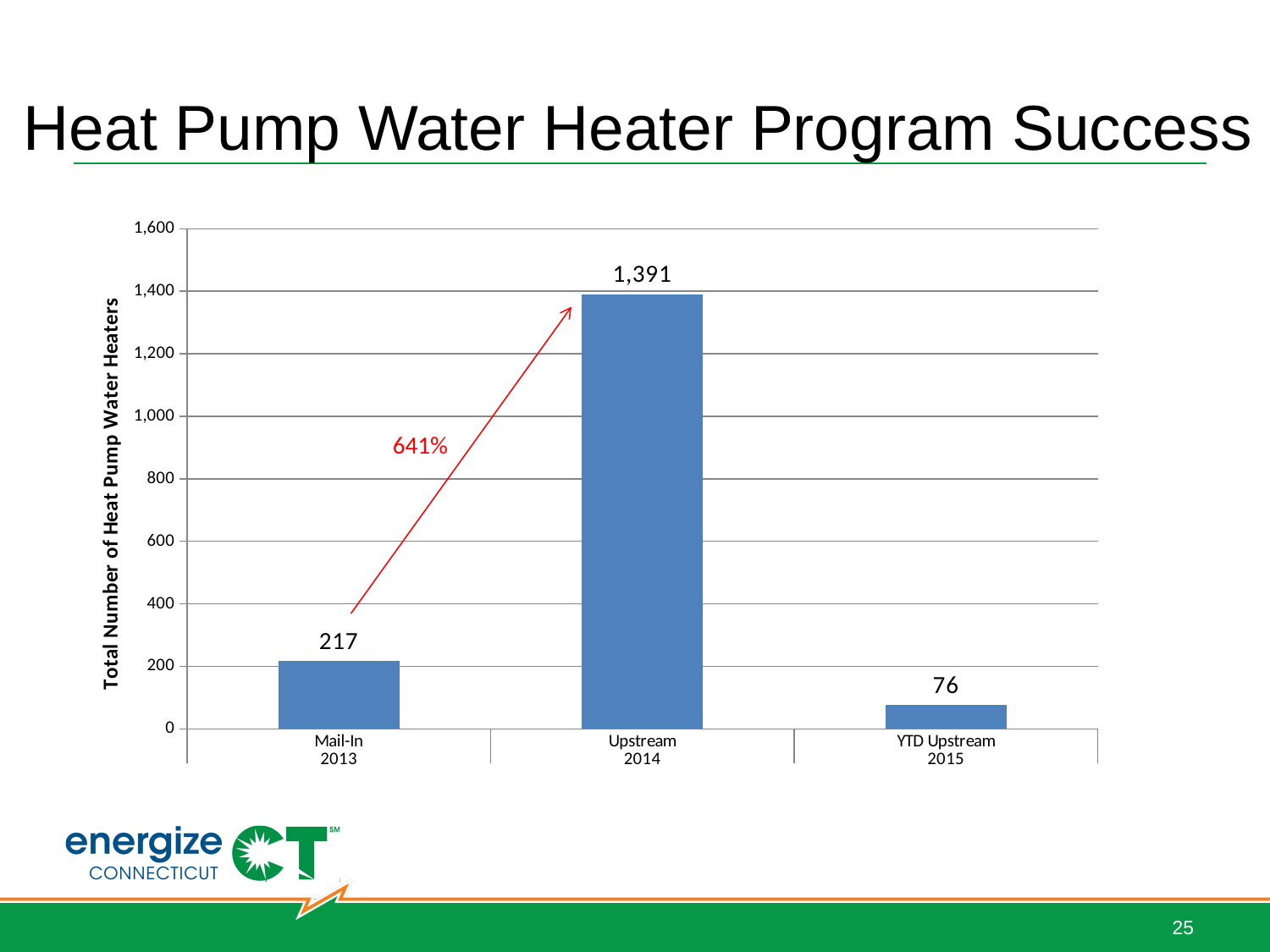
What is the difference between the values for Mail-In 2013 and YTD Upstream 2015? 141 What is the value for YTD Upstream 2015? 76 Is the value for Upstream 2014 greater or less than 1,200? greater What is the difference between the values for Upstream 2014 and Mail-In 2013? 1,174 How many categories are shown on the chart? 3 Which category has the lowest value? YTD Upstream 2015 What is the value for Mail-In 2013? 217 What is the value for Upstream 2014? 1,391 What percentage is written next to the red arrow on the chart? 641% Which category has the highest value? Upstream 2014 What kind of chart is shown on the slide? bar chart Which is larger, the value for Mail-In 2013 or the value for YTD Upstream 2015? Mail-In 2013